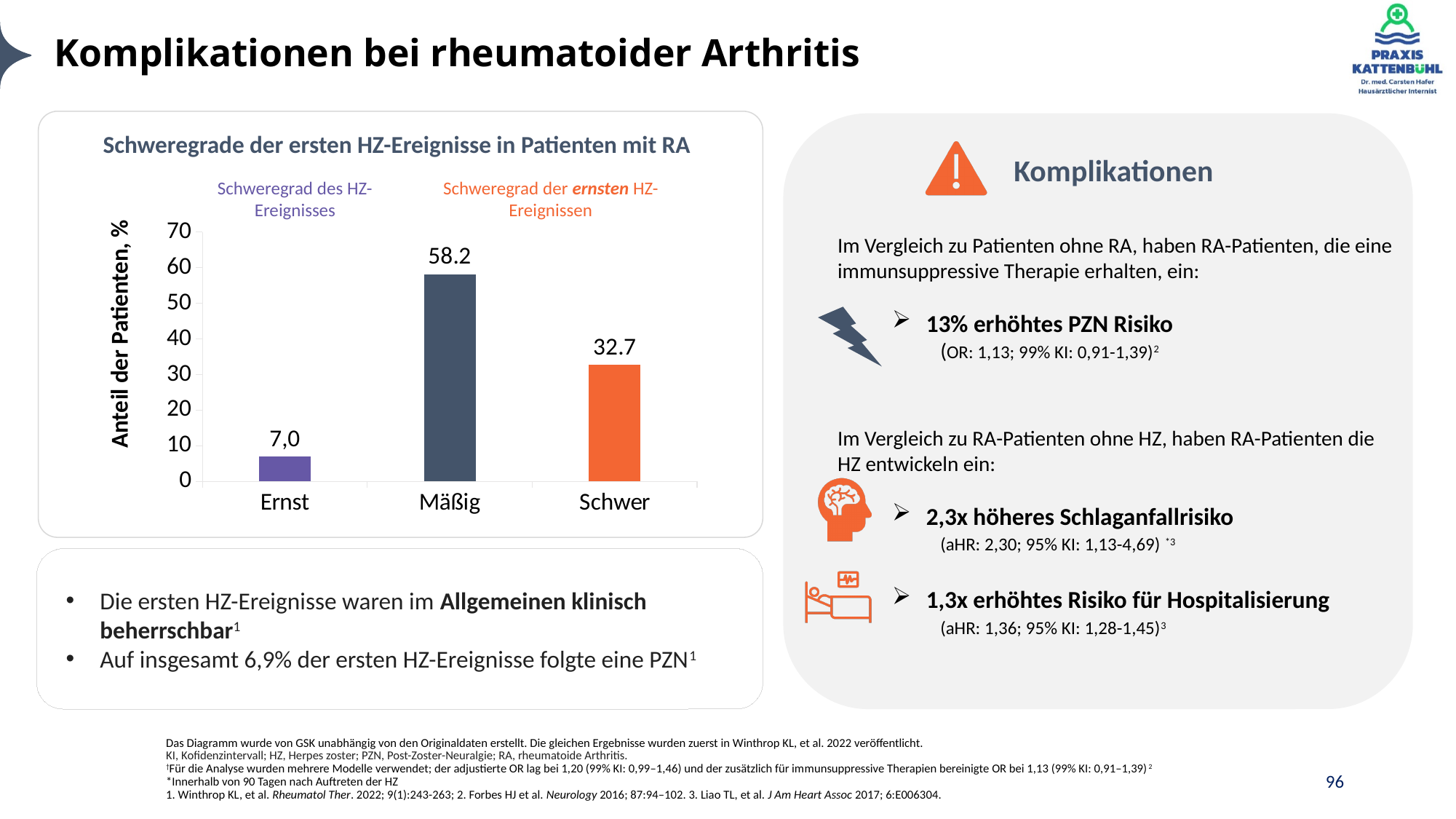
What is the label of the y axis of the chart? Anteil der Patienten, % What is the value for Ernst in the chart? 7,0 Which category has the lowest value in the chart? Ernst What kind of chart is shown on the slide? Bar chart What is the value for Mäßig in the chart 'Schweregrade der ersten HZ-Ereignisse in Patienten mit RA'? 58.2 Is the value for Schwer greater or less than 30? greater What is the difference between the values for Mäßig and Schwer? 25.5 Which category has the highest value in the chart? Mäßig How many categories are shown on the x axis of the chart? 3 What colour is the bar for Schwer? Orange What is the value for Schwer in the chart? 32.7 Which is larger, the value for Schwer or the value for Ernst? Schwer